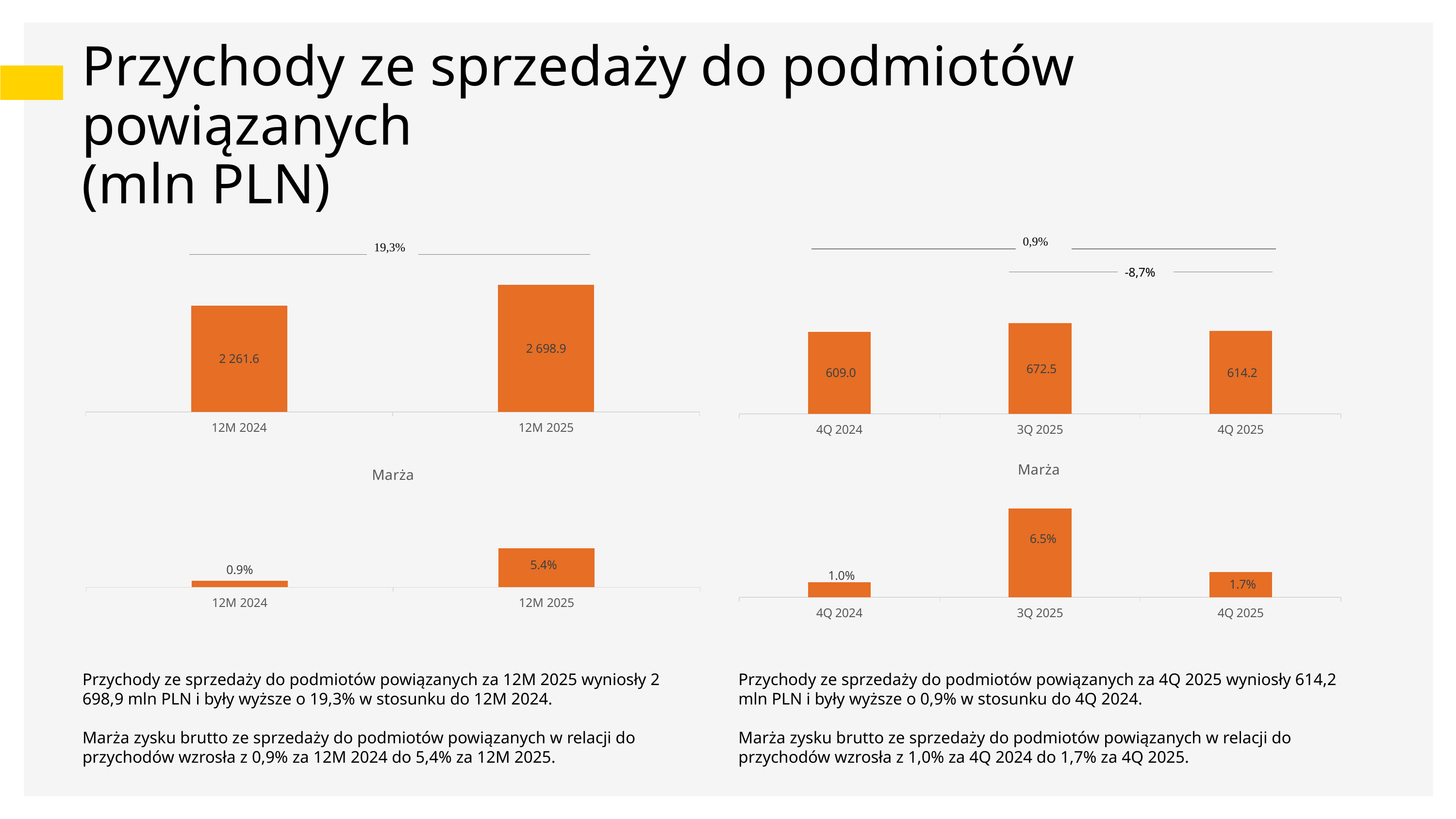
In the bottom-right chart (Marża, quarterly), what is the margin for 3Q 2025? 6.5% In the top-left chart (12M revenue), what is the value for 12M 2024? 2 261.6 In the top-right chart (quarterly revenue), what is the value for 3Q 2025? 672.5 In the top-right chart (quarterly revenue), what is the difference between 3Q 2025 and 4Q 2025? 58.3 In the top-right chart (quarterly revenue), which quarter has the highest value? 3Q 2025 In the bottom-left chart (Marża, 12M), what is the margin for 12M 2025? 5.4% What type of chart is the bottom-right chart (Marża, quarterly)? Bar chart In the top-right chart (quarterly revenue), how many quarters are shown? 3 In the top-left chart (12M revenue), what is the value for 12M 2025? 2 698.9 In the bottom-left chart (Marża, 12M), which period has the lower margin? 12M 2024 In the top-left chart (12M revenue), what percentage change is shown between 12M 2024 and 12M 2025? 19,3% In the top-right chart (quarterly revenue), what is the value for 4Q 2025? 614.2